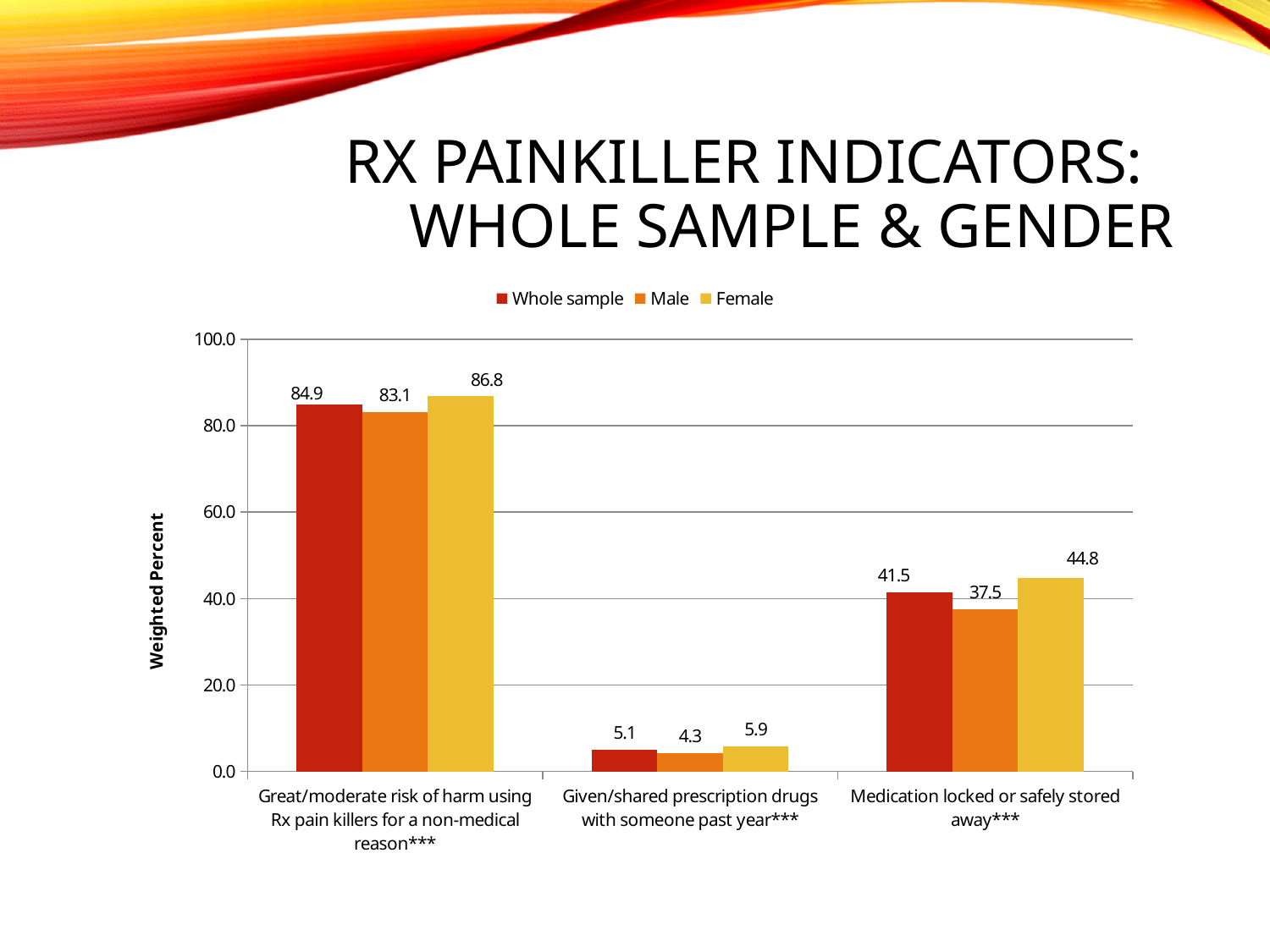
What is the Female value for "Great/moderate risk of harm using Rx pain killers for a non-medical reason"? 86.8 For "Given/shared prescription drugs with someone past year", which is larger: the Male value or the Female value? Female What is the label of the y axis? Weighted Percent Which category has the lowest Whole sample value? Given/shared prescription drugs with someone past year Is the Whole sample value for "Medication locked or safely stored away" greater or less than 40.0? greater What is the difference between the Female and Male values for "Medication locked or safely stored away"? 7.3 What is the difference between the Whole sample and Male values for "Great/moderate risk of harm using Rx pain killers for a non-medical reason"? 1.8 What is the Whole sample value for "Given/shared prescription drugs with someone past year"? 5.1 What is the Male value for "Medication locked or safely stored away"? 37.5 How many categories are shown on the x axis? 3 Which category has the highest Female value? Great/moderate risk of harm using Rx pain killers for a non-medical reason How many series does the legend list? 3